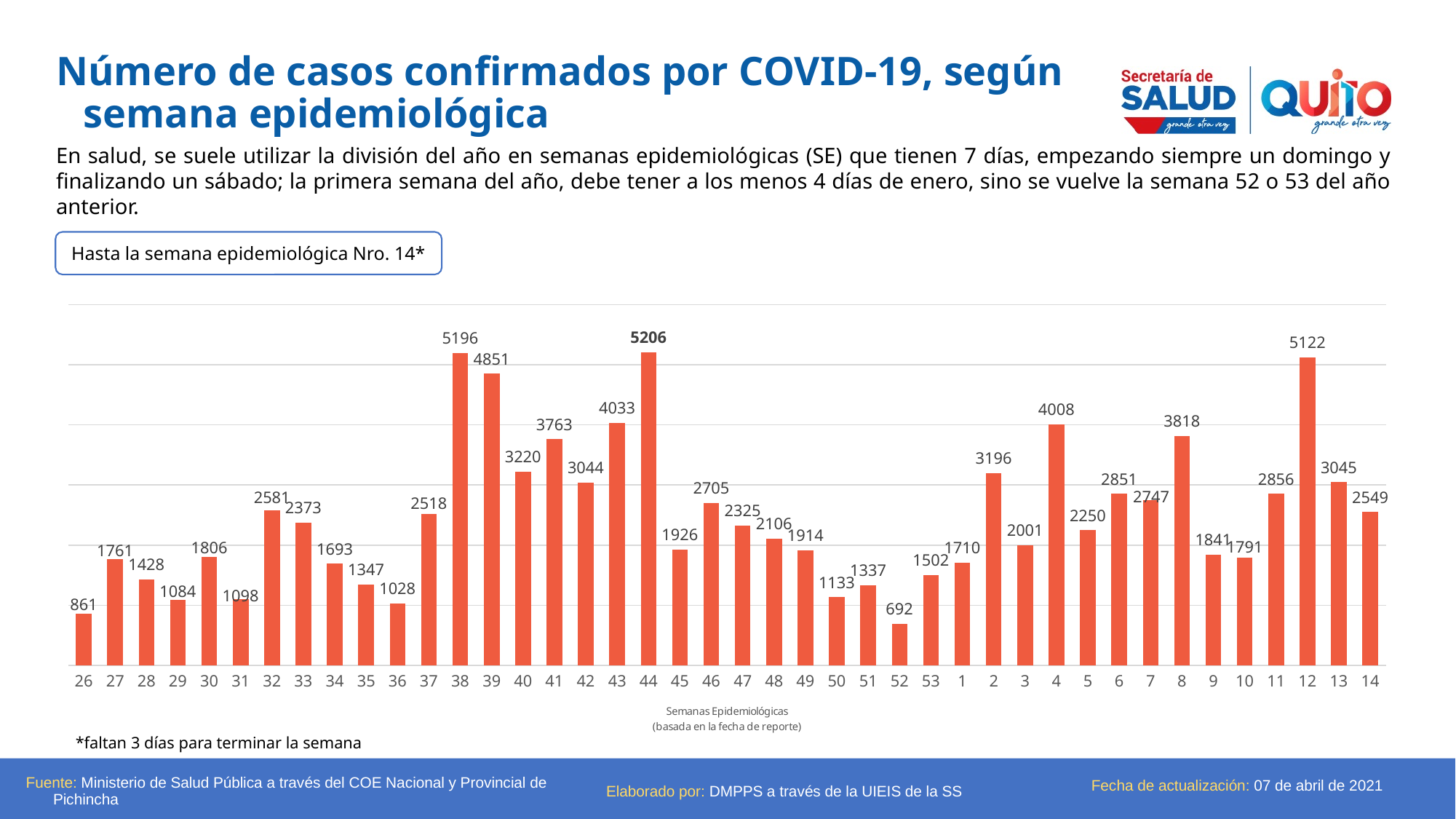
What is the difference between the values for week 12 and week 14? 2573 What is the value for epidemiological week 12? 5122 What is the value for epidemiological week 52? 692 How many confirmed COVID-19 cases are shown for epidemiological week 44? 5206 How many epidemiological weeks (bars) are plotted in the chart? 42 Which has a higher value, epidemiological week 4 or week 8? Week 4 Do the values rise or fall from week 52 through week 2? Rise Which epidemiological week has the highest number of confirmed cases? 44 Which epidemiological week has the lowest number of confirmed cases? 52 What is the label of the x axis of the chart? Semanas Epidemiológicas (basada en la fecha de reporte) What is the difference between the values for week 38 and week 39? 345 What type of chart is shown on the slide? Bar chart